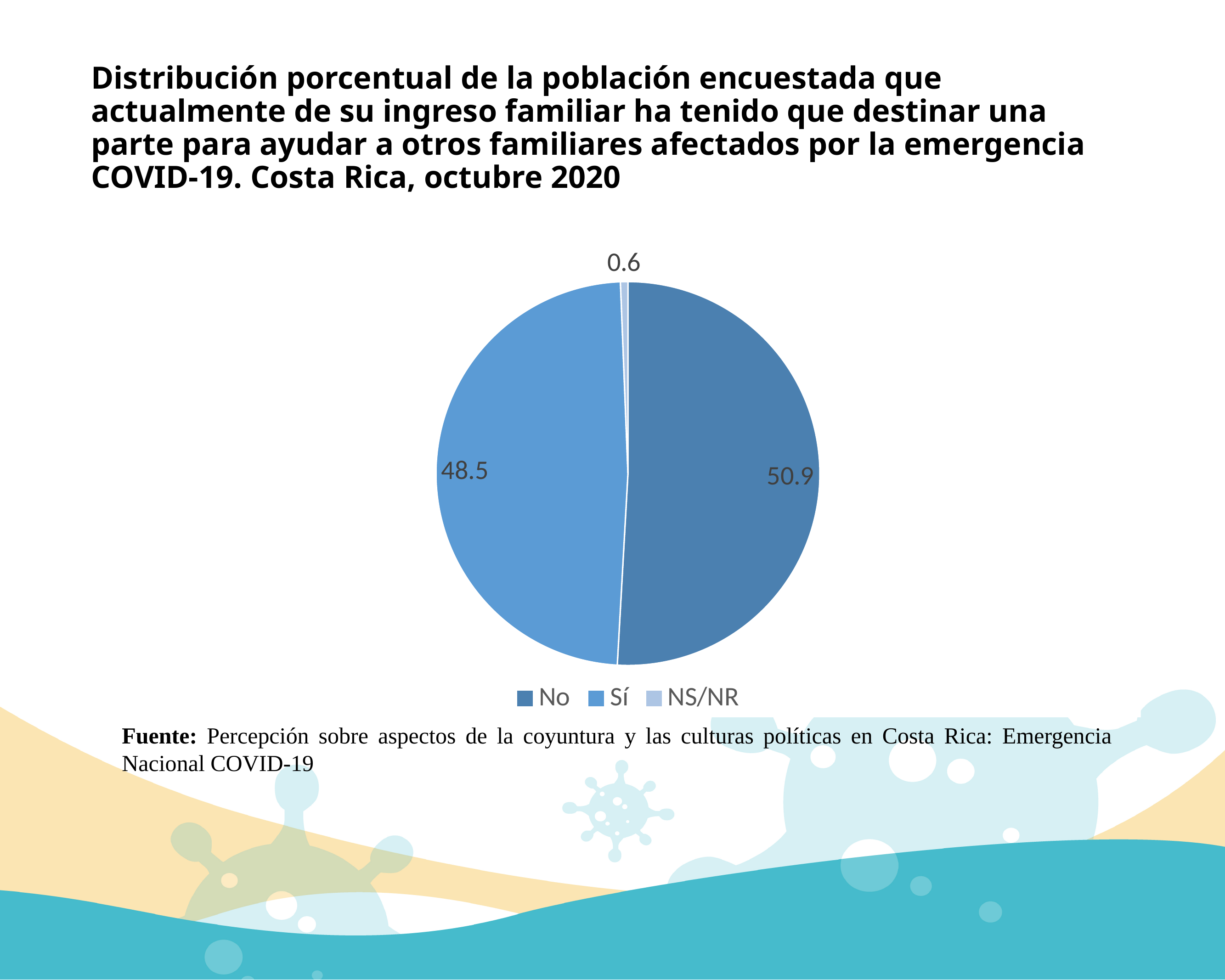
Which category has the smallest slice? NS/NR What is the value for the "Sí" slice? 48.5 Which category has the largest slice? No How many categories does the legend list? 3 Which legend entry is shown in the lightest blue colour? NS/NR What is the value for the "NS/NR" slice? 0.6 What is the difference between the "Sí" and "NS/NR" values? 47.9 Which is larger, the "Sí" slice or the "NS/NR" slice? Sí What type of chart is shown on the slide? Pie chart What is the value for the "No" slice? 50.9 What is the difference between the "No" and "Sí" values? 2.4 What month and year does the chart title refer to? octubre 2020